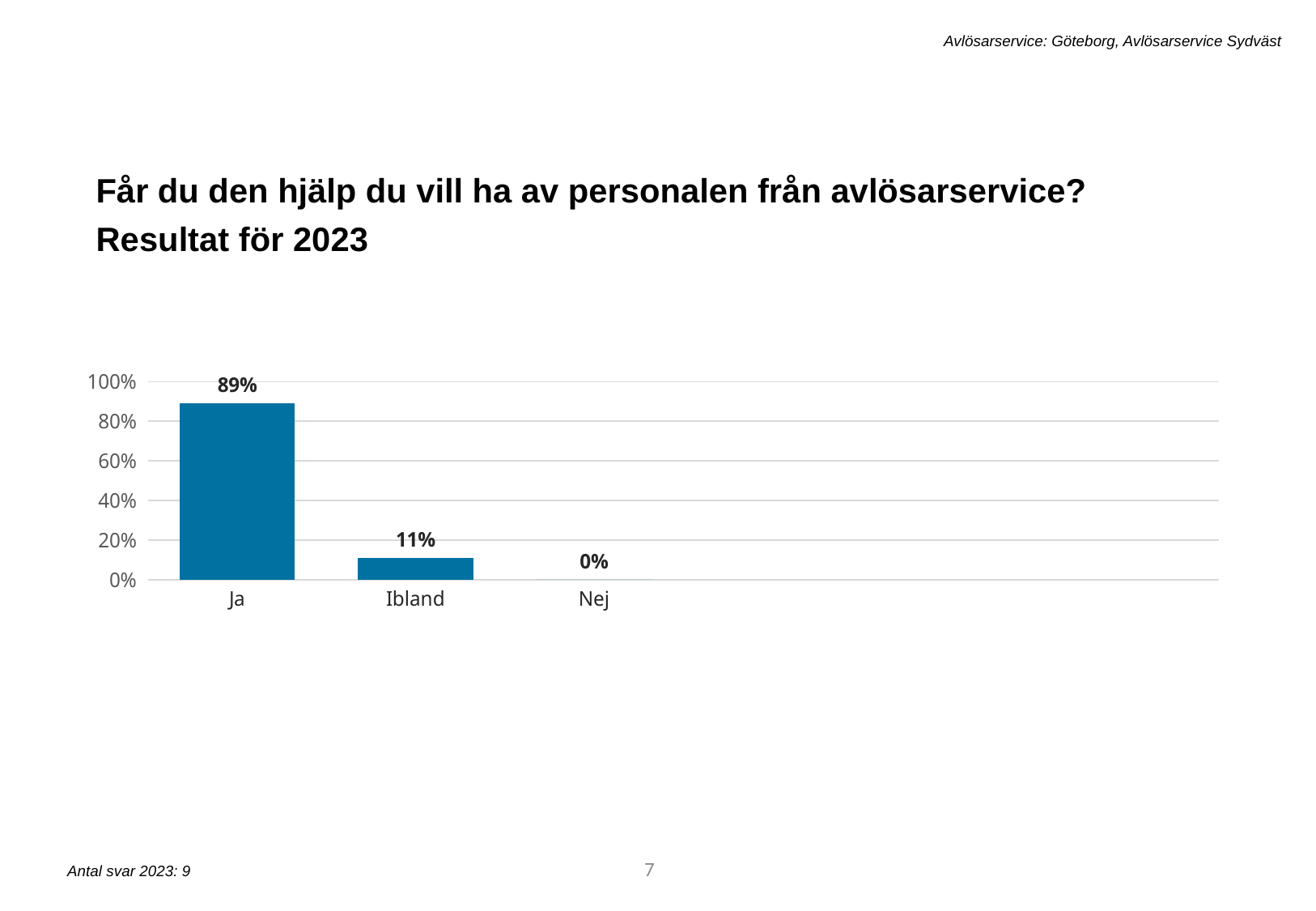
What is the difference between the values for Ja and Ibland? 78% Is the value for Ja greater or less than 80%? greater What is the value for Ibland? 11% What kind of chart is shown on the slide? bar chart What is the value for Ja? 89% Which category has the highest value? Ja Which is larger, the value for Ibland or the value for Nej? Ibland Is the value for Ibland greater or less than 20%? less Which category has the lowest value? Nej How many categories are shown on the x axis? 3 What is the value for Nej? 0% Do the values rise or fall from left to right along the x axis? fall